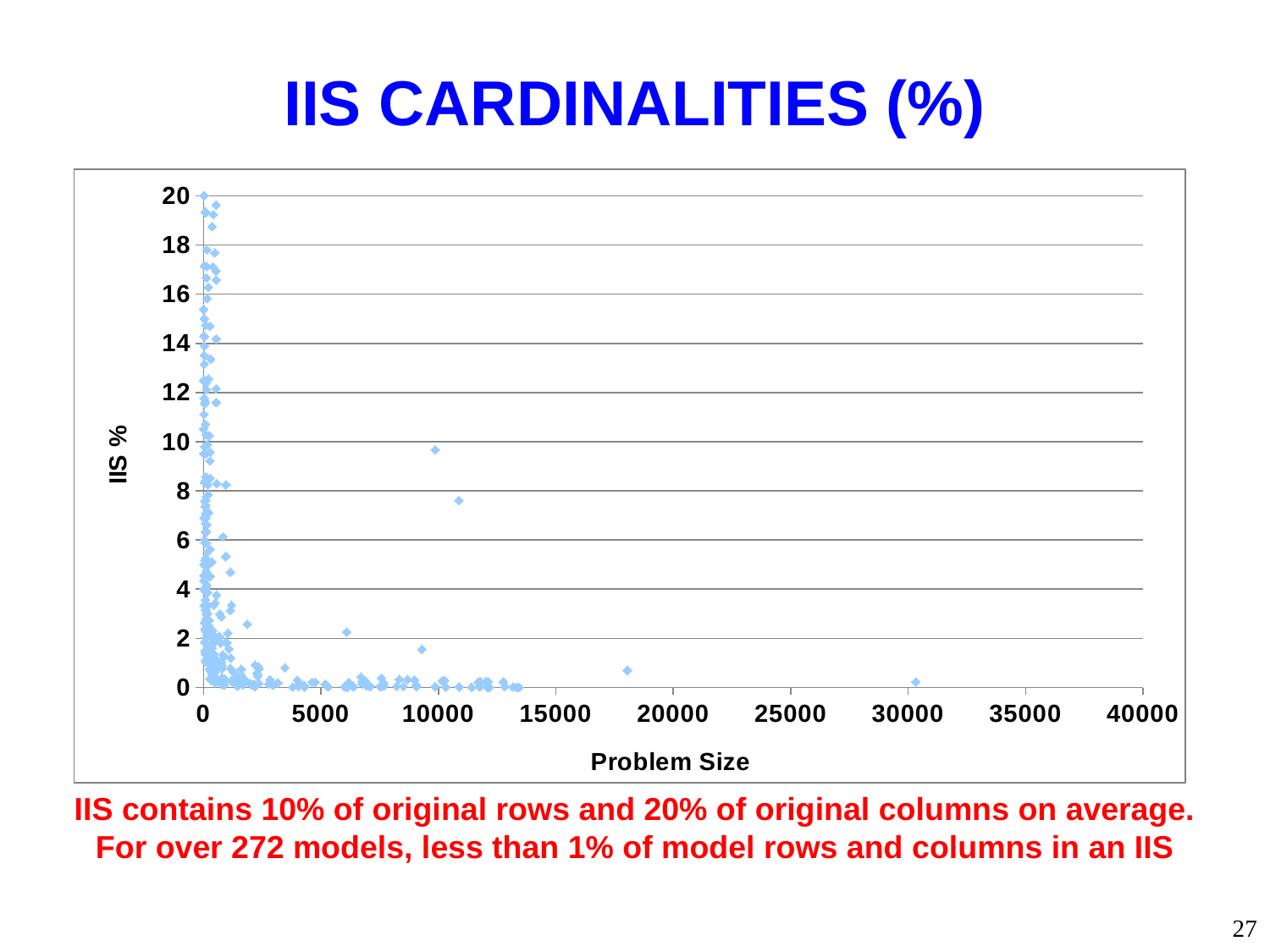
What is the label of the horizontal axis of the chart? Problem Size What is the highest value shown on the vertical (IIS %) axis? 20 What kind of chart is shown on the slide? scatter chart Is the IIS % value for the point plotted at a problem size of about 18000 greater or less than 2? less Is the IIS % value for the point plotted at a problem size of about 11000 greater or less than 6? greater What is the highest value shown on the horizontal (Problem Size) axis? 40000 What is the title of the chart? IIS CARDINALITIES (%) Is the IIS % value for the isolated point plotted at a problem size of about 10000 greater or less than 8? greater As problem size increases along the x axis, do the IIS % values generally rise or fall? fall